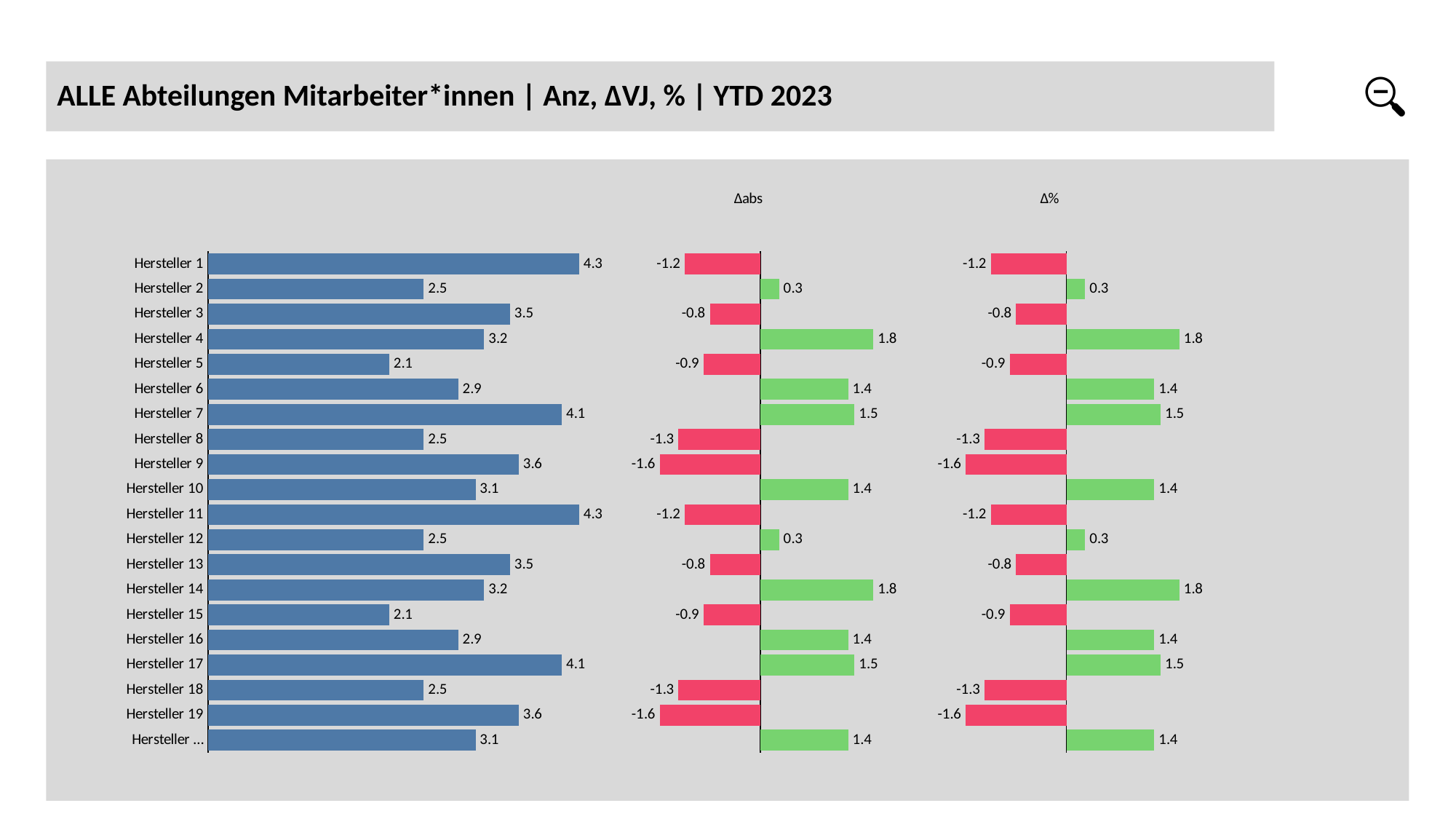
In the left chart, what is the value for Hersteller 15? 2.1 What is the title of the slide? ALLE Abteilungen Mitarbeiter*innen | Anz, ΔVJ, % | YTD 2023 In the Δabs chart, what is the value for Hersteller 9? -1.6 In the Δabs chart, which is larger, the value for Hersteller 6 or the value for Hersteller 7? Hersteller 7 In the Δabs chart, what is the value for Hersteller 12? 0.3 In the left chart, what is the difference between the values for Hersteller 1 and Hersteller 2? 1.8 In the Δ% chart, what colour are the bars with negative values? red What kind of chart is the left chart? bar chart In the left chart, which is larger, the value for Hersteller 3 or the value for Hersteller 6? Hersteller 3 In the Δ% chart, what is the value for Hersteller 4? 1.8 How many categories (Hersteller) are shown in the left chart? 20 In the left chart, what is the value for Hersteller 7? 4.1